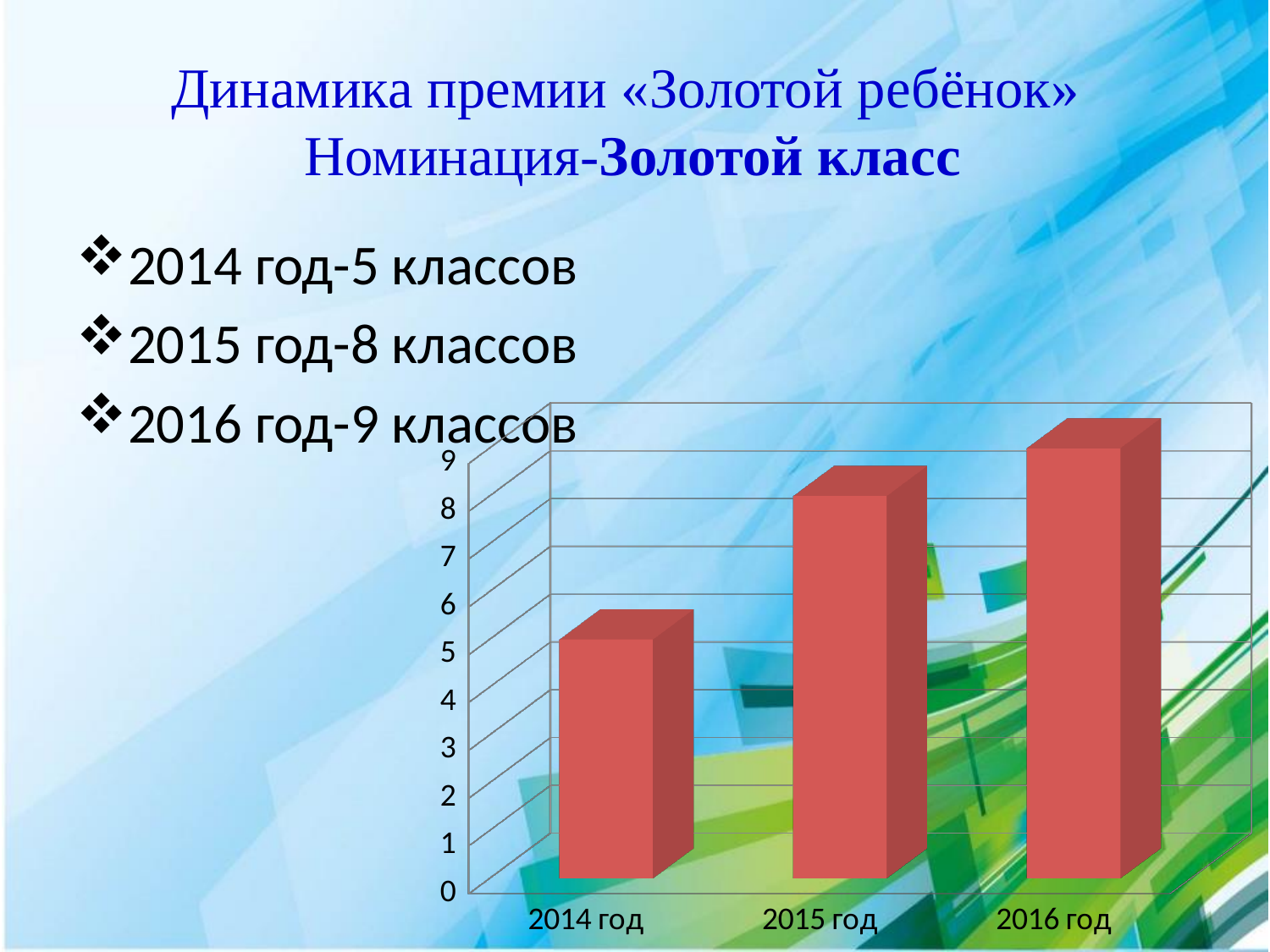
Which year has the lowest bar? 2014 год What is the value for 2016 год? 9 Is the value for 2014 год greater or less than 6? less What is the value for 2015 год? 8 Do the values rise or fall from 2014 год to 2016 год? rise What is the maximum value shown on the vertical axis? 9 Which year has the highest bar? 2016 год What is the value for 2014 год? 5 How many bars (categories) does the chart show? 3 Which is larger, the value for 2015 год or the value for 2016 год? 2016 год What is the difference between the values for 2015 год and 2014 год? 3 What type of chart is shown on the slide? bar chart